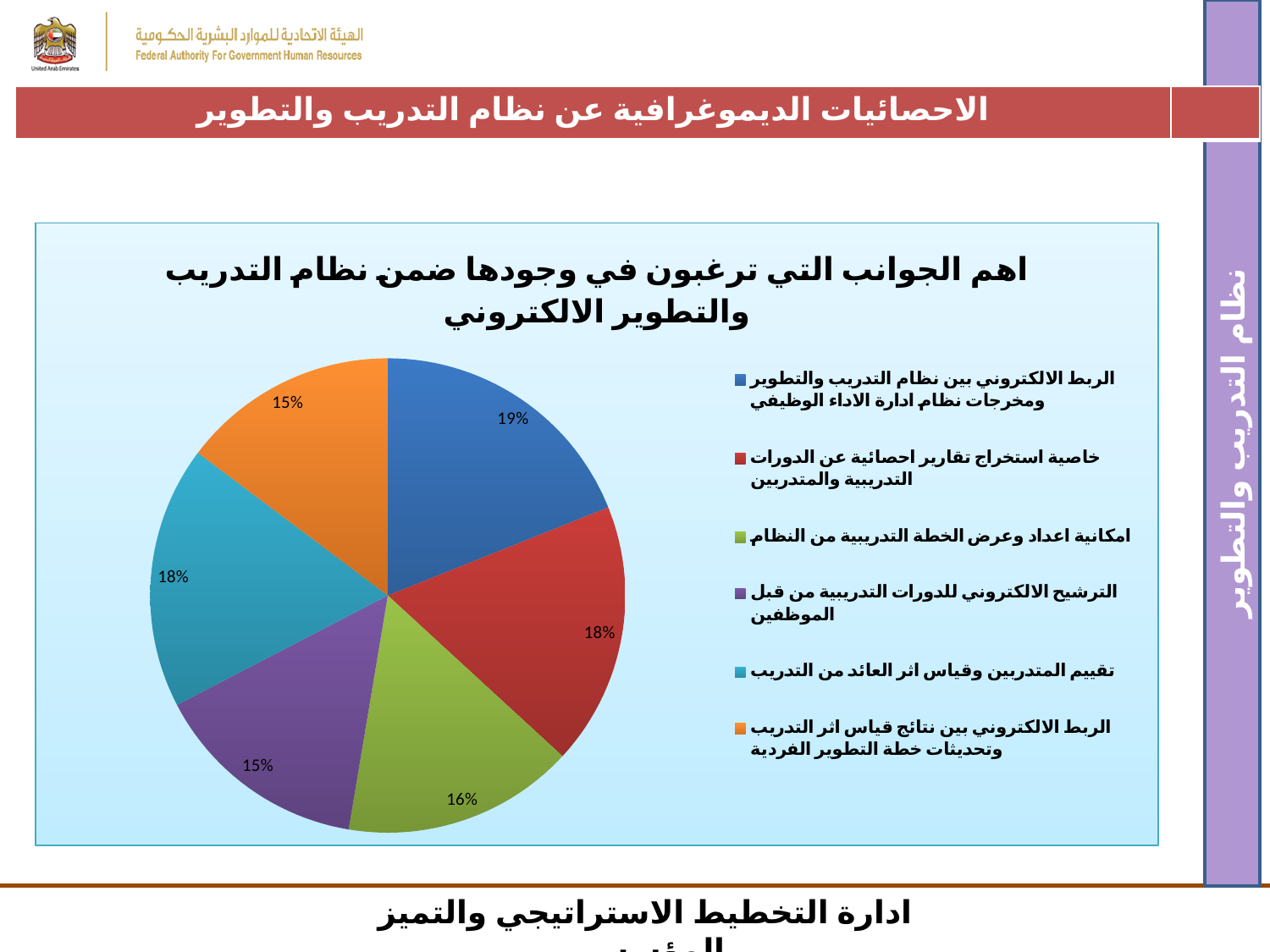
What share of the pie does "الربط الالكتروني بين نظام التدريب والتطوير ومخرجات نظام ادارة الاداء الوظيفي" have? 19% What is the difference in percentage points between the largest slice (19%) and the slice for "الربط الالكتروني بين نتائج قياس اثر التدريب وتحديثات خطة التطوير الفردية"? 4% How many entries does the legend of the pie chart list? 6 What percentage is shown for "امكانية اعداد وعرض الخطة التدريبية من النظام"? 16% How many slices does the pie chart have? 6 What percentage is shown for "تقييم المتدربين وقياس اثر العائد من التدريب"? 18% Which is larger: the share for "خاصية استخراج تقارير احصائية عن الدورات التدريبية والمتدربين" or for "امكانية اعداد وعرض الخطة التدريبية من النظام"? خاصية استخراج تقارير احصائية عن الدورات التدريبية والمتدربين Which category has the largest share of the pie? الربط الالكتروني بين نظام التدريب والتطوير ومخرجات نظام ادارة الاداء الوظيفي What is the title of the pie chart? اهم الجوانب التي ترغبون في وجودها ضمن نظام التدريب والتطوير الالكتروني What colour is the slice for "تقييم المتدربين وقياس اثر العائد من التدريب"? teal (light blue) What percentage is shown for "الترشيح الالكتروني للدورات التدريبية من قبل الموظفين"? 15% What kind of chart is shown on the slide? pie chart